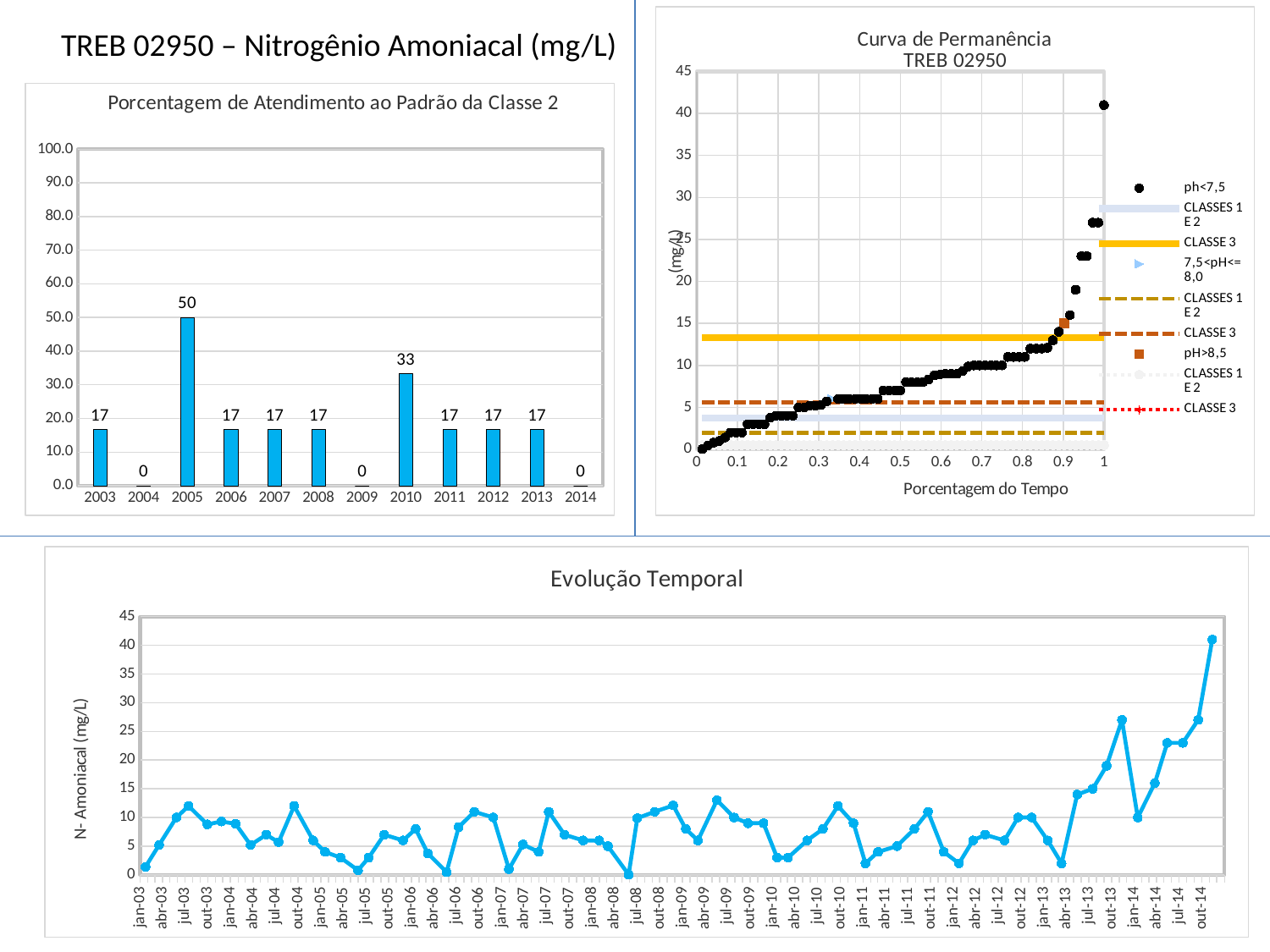
In the chart 'Porcentagem de Atendimento ao Padrão da Classe 2', what is the difference between the values for 2005 and 2010? 17 In the chart 'Porcentagem de Atendimento ao Padrão da Classe 2', what is the value for 2005? 50 What kind of chart is 'Evolução Temporal'? line chart What kind of chart is 'Porcentagem de Atendimento ao Padrão da Classe 2'? bar chart In the chart 'Porcentagem de Atendimento ao Padrão da Classe 2', which year has the highest value? 2005 In the chart 'Curva de Permanência TREB 02950', what is the title of the x axis? Porcentagem do Tempo In the chart 'Porcentagem de Atendimento ao Padrão da Classe 2', what is the value for 2009? 0 In the chart 'Porcentagem de Atendimento ao Padrão da Classe 2', how many years are shown on the x axis? 12 In the chart 'Porcentagem de Atendimento ao Padrão da Classe 2', what is the value for 2010? 33 In the chart 'Evolução Temporal', is the value for out-14 greater or less than 35? greater In the chart 'Porcentagem de Atendimento ao Padrão da Classe 2', which is larger, the value for 2010 or the value for 2003? 2010 In the chart 'Curva de Permanência TREB 02950', how many entries does the legend list? 9